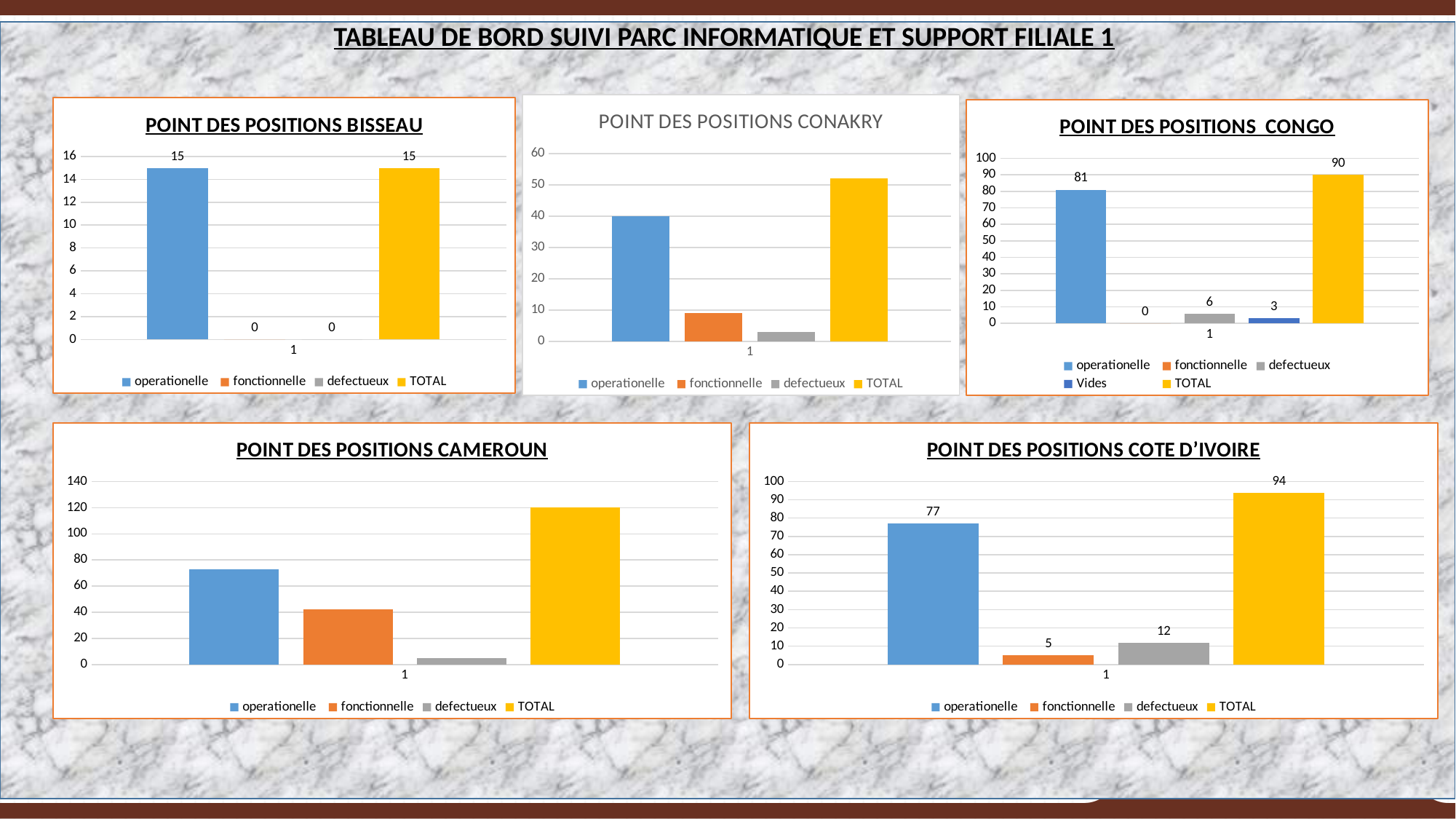
In the POINT DES POSITIONS CONGO chart, what colour is the Vides bar? dark blue In the POINT DES POSITIONS COTE D'IVOIRE chart, what is the value for defectueux? 12 How many series does the legend of the POINT DES POSITIONS CONGO chart list? 5 In the POINT DES POSITIONS CONAKRY chart, is the value for TOTAL greater or less than 50? greater In the POINT DES POSITIONS COTE D'IVOIRE chart, which is larger, fonctionnelle or defectueux? defectueux In the POINT DES POSITIONS CONGO chart, what is the value for Vides? 3 In the POINT DES POSITIONS CONGO chart, which series has the lowest value? fonctionnelle What kind of chart is POINT DES POSITIONS CAMEROUN? bar chart In the POINT DES POSITIONS CAMEROUN chart, is the value for fonctionnelle greater or less than 60? less In the POINT DES POSITIONS COTE D'IVOIRE chart, what is the difference between TOTAL and operationelle? 17 In the POINT DES POSITIONS BISSEAU chart, what is the value for operationelle? 15 In the POINT DES POSITIONS CONGO chart, what is the value for TOTAL? 90